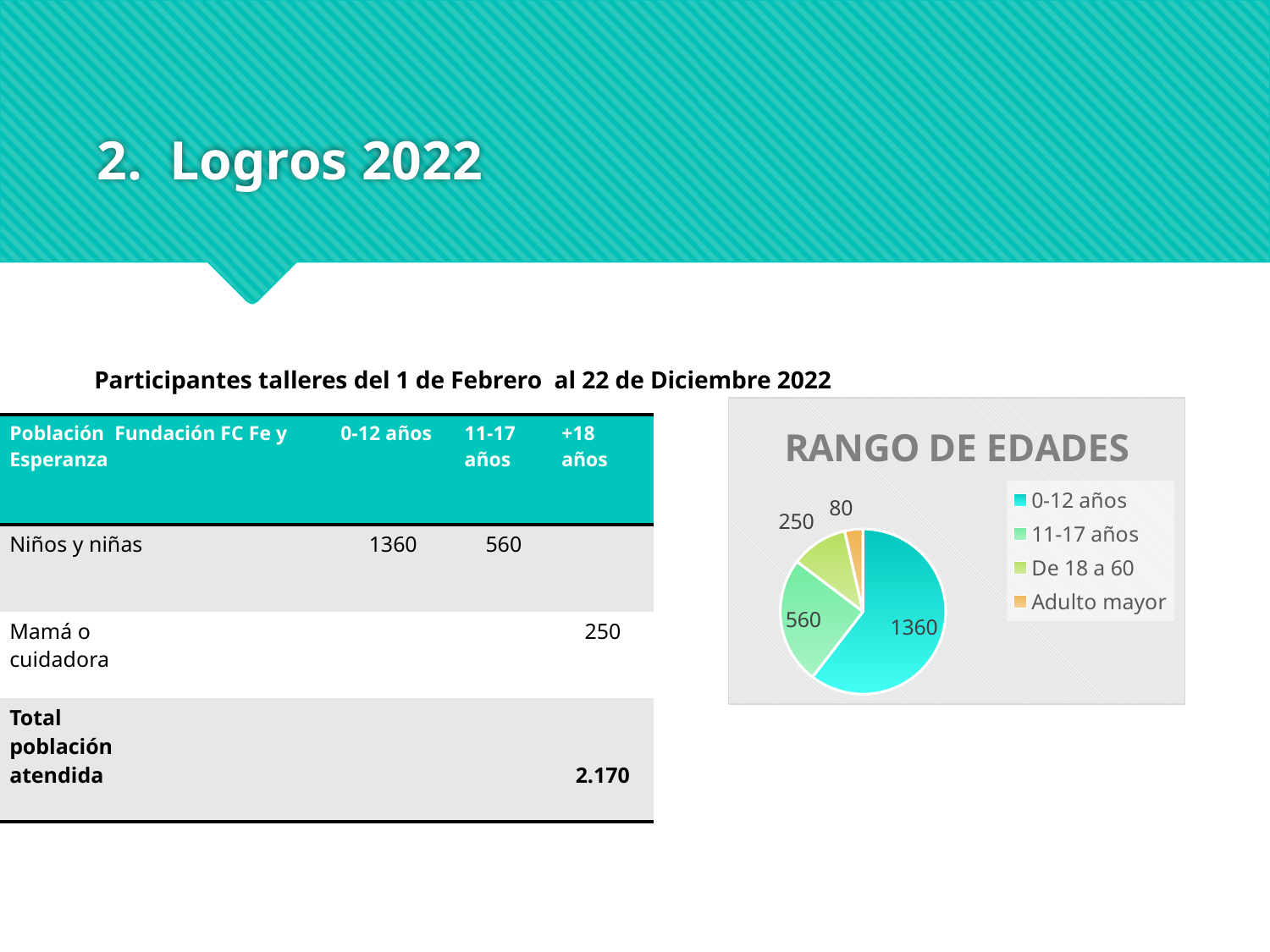
What is the total of all four slices in the pie chart? 2250 Which category has the largest slice of the pie? 0-12 años What kind of chart is shown on the slide? pie chart What is the value for the 11-17 años slice? 560 How many categories does the pie chart's legend list? 4 Which category has the smallest slice of the pie? Adulto mayor What is the value for the De 18 a 60 slice? 250 What is the title of the chart? RANGO DE EDADES What is the difference between the 0-12 años value and the 11-17 años value? 800 What is the value for the Adulto mayor slice? 80 Which is larger, the De 18 a 60 slice or the Adulto mayor slice? De 18 a 60 What is the value for the 0-12 años slice? 1360